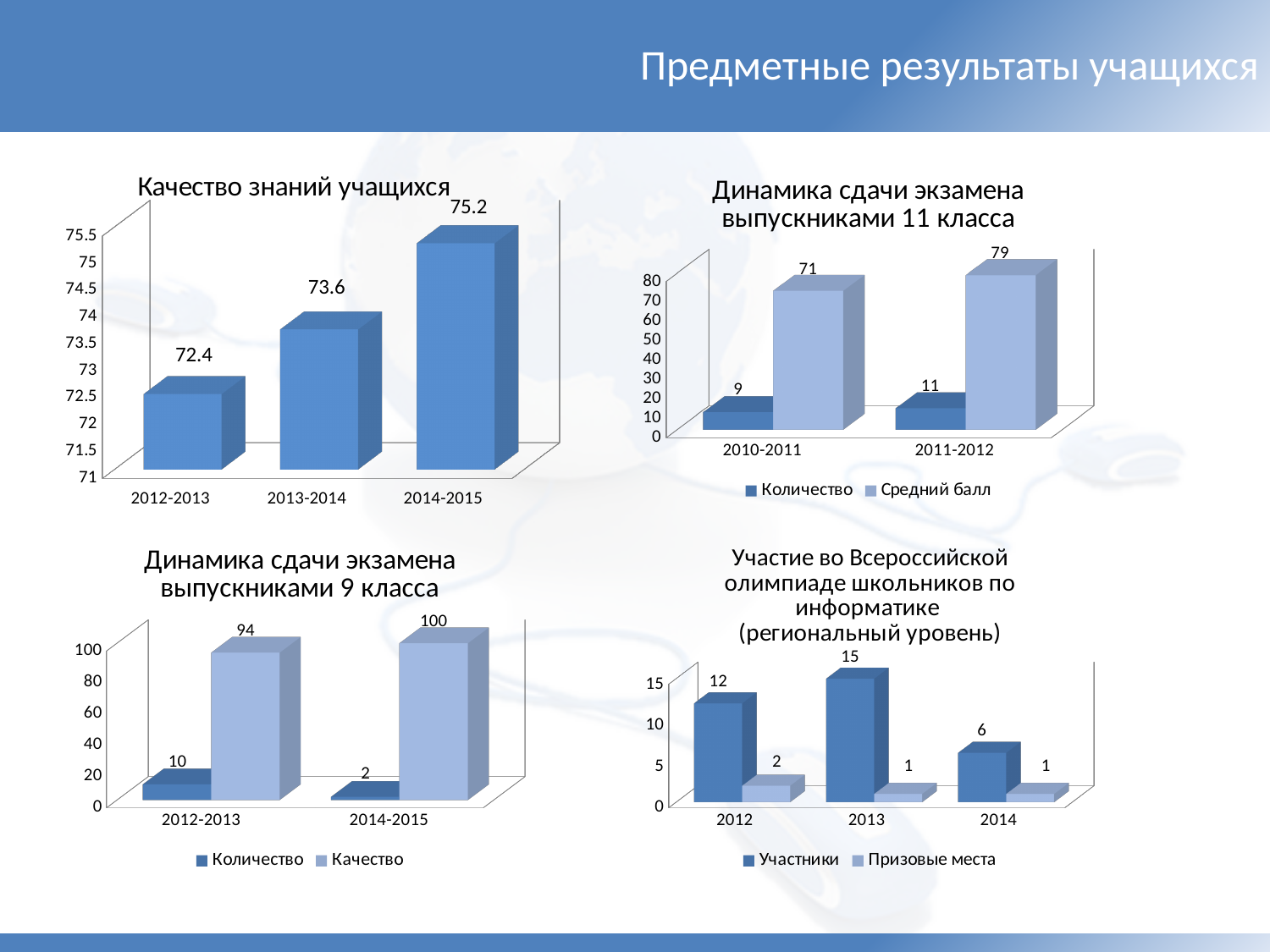
In the chart 'Участие во Всероссийской олимпиаде школьников по информатике', which year has the most 'Участники'? 2013 In the chart 'Качество знаний учащихся', do the values rise or fall from 2012-2013 to 2014-2015? rise In the chart 'Участие во Всероссийской олимпиаде школьников по информатике', what is the 'Призовые места' value for 2012? 2 In the chart 'Динамика сдачи экзамена выпускниками 9 класса', which year has the higher 'Качество' value, 2012-2013 or 2014-2015? 2014-2015 In the chart 'Качество знаний учащихся', which year has the highest value? 2014-2015 In the chart 'Качество знаний учащихся', what is the value for 2013-2014? 73.6 In the chart 'Качество знаний учащихся', what is the difference between the 2014-2015 and 2012-2013 values? 2.8 In the chart 'Динамика сдачи экзамена выпускниками 11 класса', what is the 'Средний балл' value for 2011-2012? 79 In the chart 'Динамика сдачи экзамена выпускниками 9 класса', what is the 'Количество' value for 2014-2015? 2 How many series does the legend of the chart 'Динамика сдачи экзамена выпускниками 11 класса' list? 2 In the chart 'Динамика сдачи экзамена выпускниками 11 класса', what is the difference in 'Количество' between 2011-2012 and 2010-2011? 2 How many charts are shown on the slide, and what type are they? 4 bar charts